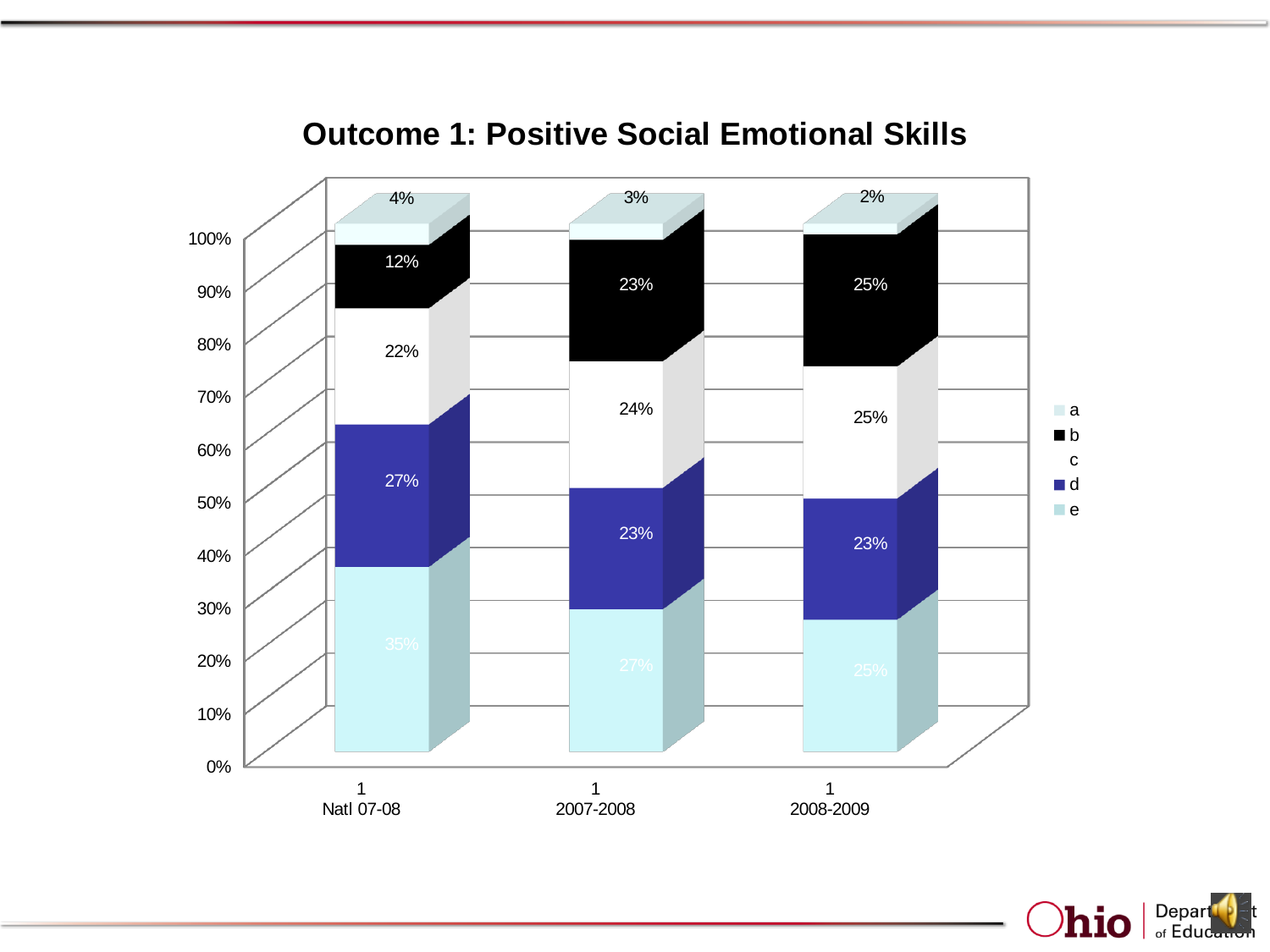
What is the value of series e for 2007-2008? 27% What is the title of the chart? Outcome 1: Positive Social Emotional Skills What is the value of series c for 2007-2008? 24% What is the value of series b for Natl 07-08? 12% What is the difference between the series b values for 2008-2009 and Natl 07-08? 13% How many bars are plotted in the chart? 3 What kind of chart is shown on the slide? stacked bar chart How many series does the legend list? 5 Which category has the highest value for series e? Natl 07-08 What is the value of series a for 2008-2009? 2% Which is larger: series d for Natl 07-08 or series d for 2008-2009? Natl 07-08 Which category has the lowest value for series b? Natl 07-08